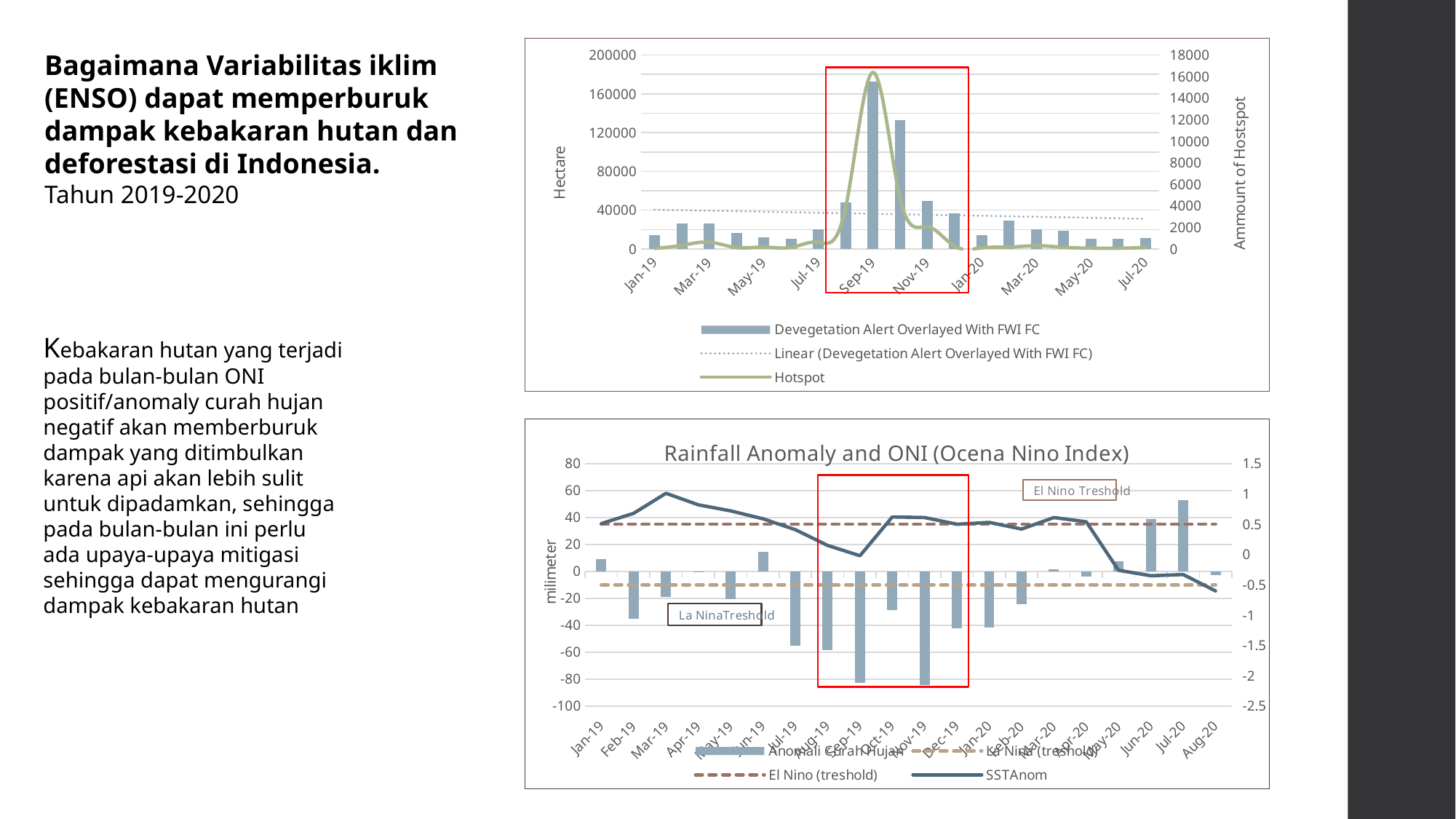
In the bottom chart, is the Anomali Curah Hujan value for Jul-20 greater or less than 40? greater In the top chart, which month has the highest Devegetation Alert Overlayed With FWI FC bar? Sep-19 In the bottom chart, which month has the highest Anomali Curah Hujan bar? Jul-20 In the top chart, what is the label of the left vertical axis? Hectare In the bottom chart, in which month does the SSTAnom line reach its highest point? Mar-19 In the bottom chart, is the Anomali Curah Hujan value for Sep-19 greater or less than -60? less In the top chart, is the Devegetation Alert Overlayed With FWI FC value for Jan-19 greater or less than 40000? less What is the title of the bottom chart? Rainfall Anomaly and ONI (Ocena Nino Index) In the bottom chart, how many series does the legend list? 4 In the top chart, how many series does the legend list? 3